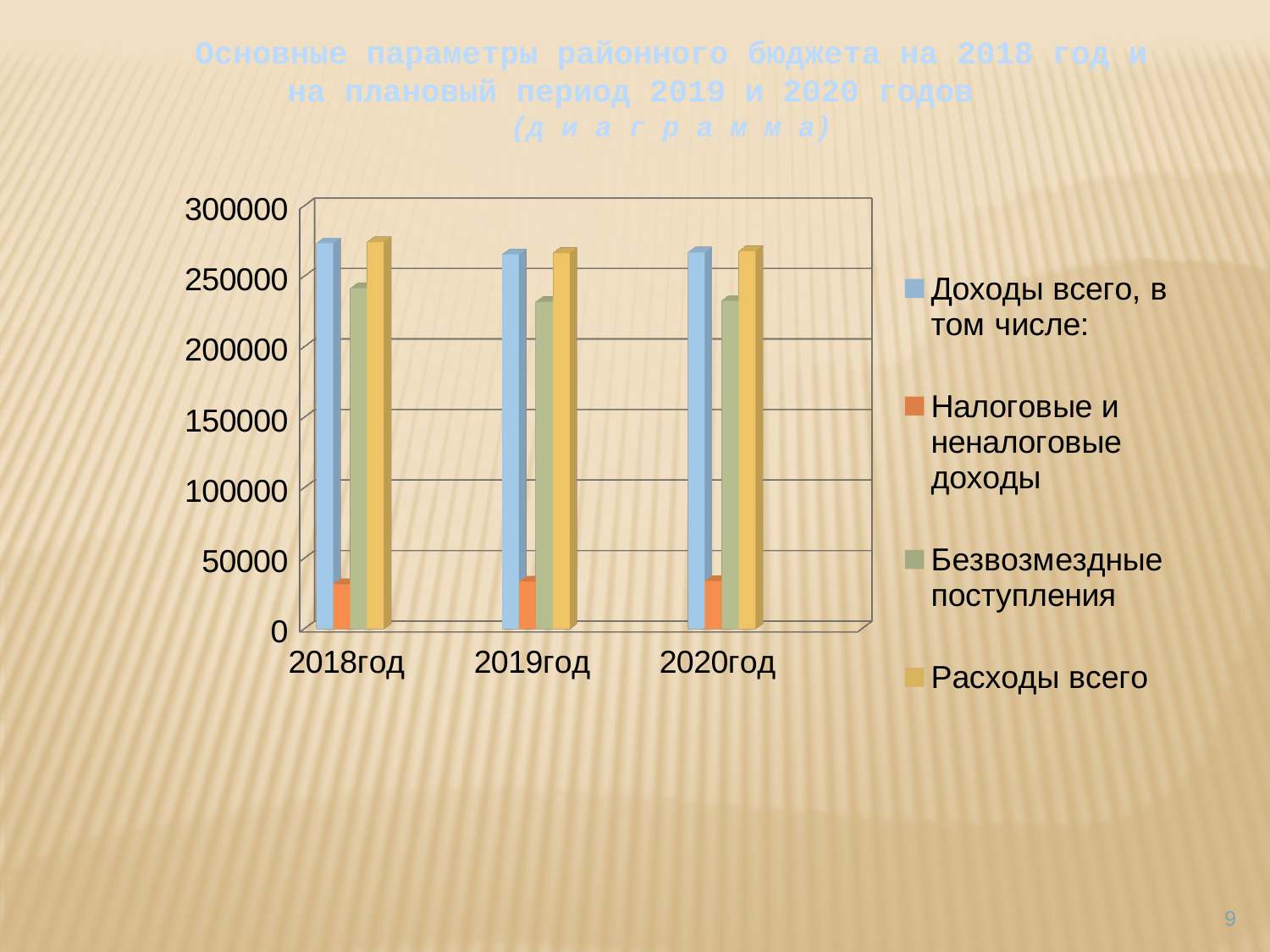
Is the value of Налоговые и неналоговые доходы for 2018год greater or less than 50000? less How many year categories are shown on the x axis? 3 How many series does the legend list? 4 What colour represents Расходы всего in the legend? yellow Which series has the lowest value for 2018год? Налоговые и неналоговые доходы For 2020год, which is larger: Доходы всего or Безвозмездные поступления? Доходы всего Is the value of Расходы всего for 2020год greater or less than 250000? greater Which series has the lowest value for 2020год? Налоговые и неналоговые доходы For 2019год, which is larger: Безвозмездные поступления or Налоговые и неналоговые доходы? Безвозмездные поступления Is the value of Безвозмездные поступления for 2019год greater or less than 200000? greater What kind of chart is shown on the slide? bar chart